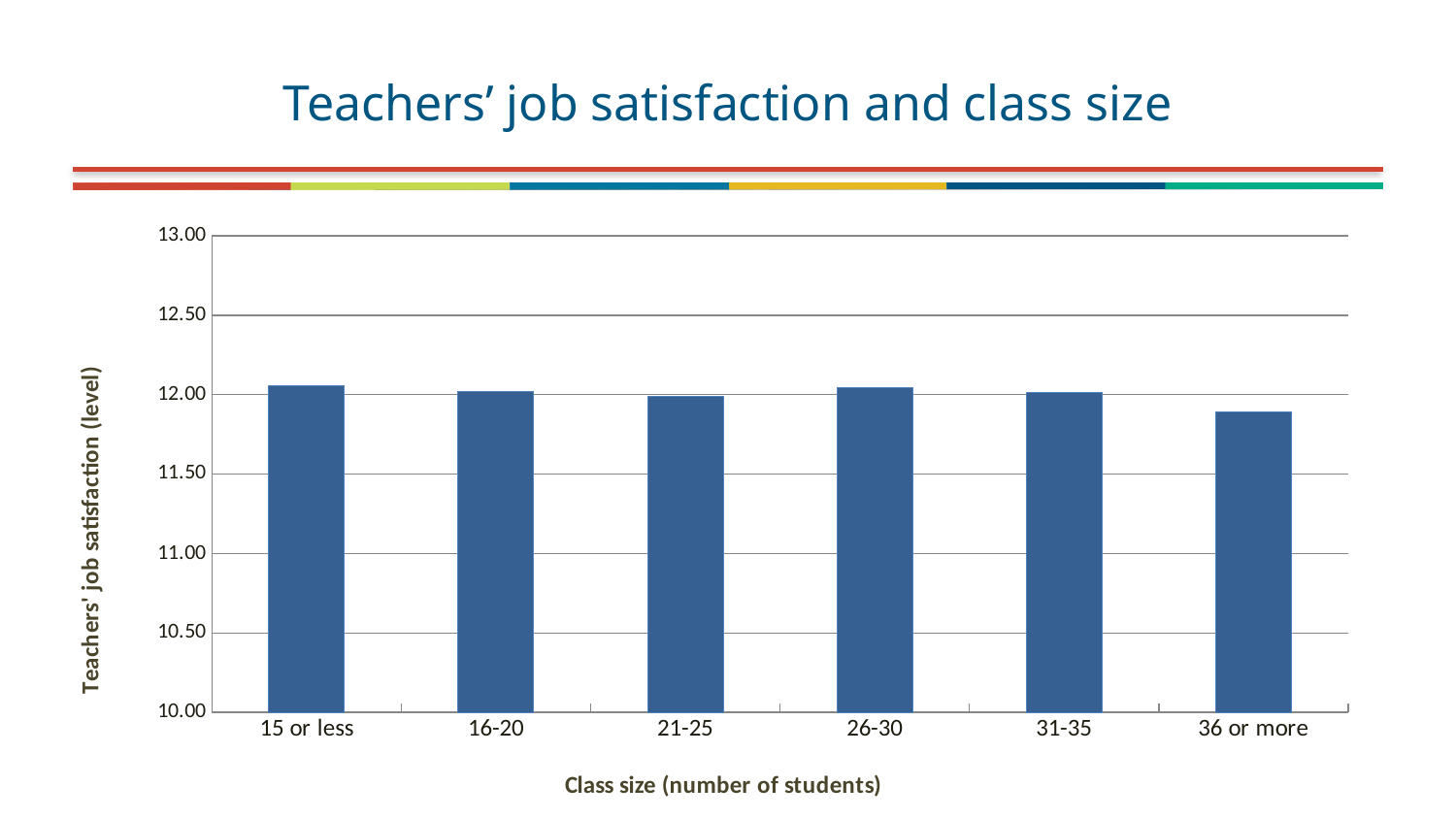
What is the title of the chart? Teachers' job satisfaction and class size Is the value for the '26-30' class size greater or less than 11.50? greater How many class-size categories are shown on the x axis? 6 Which has the higher teachers' job satisfaction: '15 or less' or '36 or more'? 15 or less Is the value for the '36 or more' class size greater or less than 12.00? less What is the label of the x axis? Class size (number of students) What kind of chart is shown on the slide? bar chart Is the value for the '31-35' class size greater or less than 12.50? less Which class-size category has the lowest teachers' job satisfaction? 36 or more Which has the higher teachers' job satisfaction: '26-30' or '36 or more'? 26-30